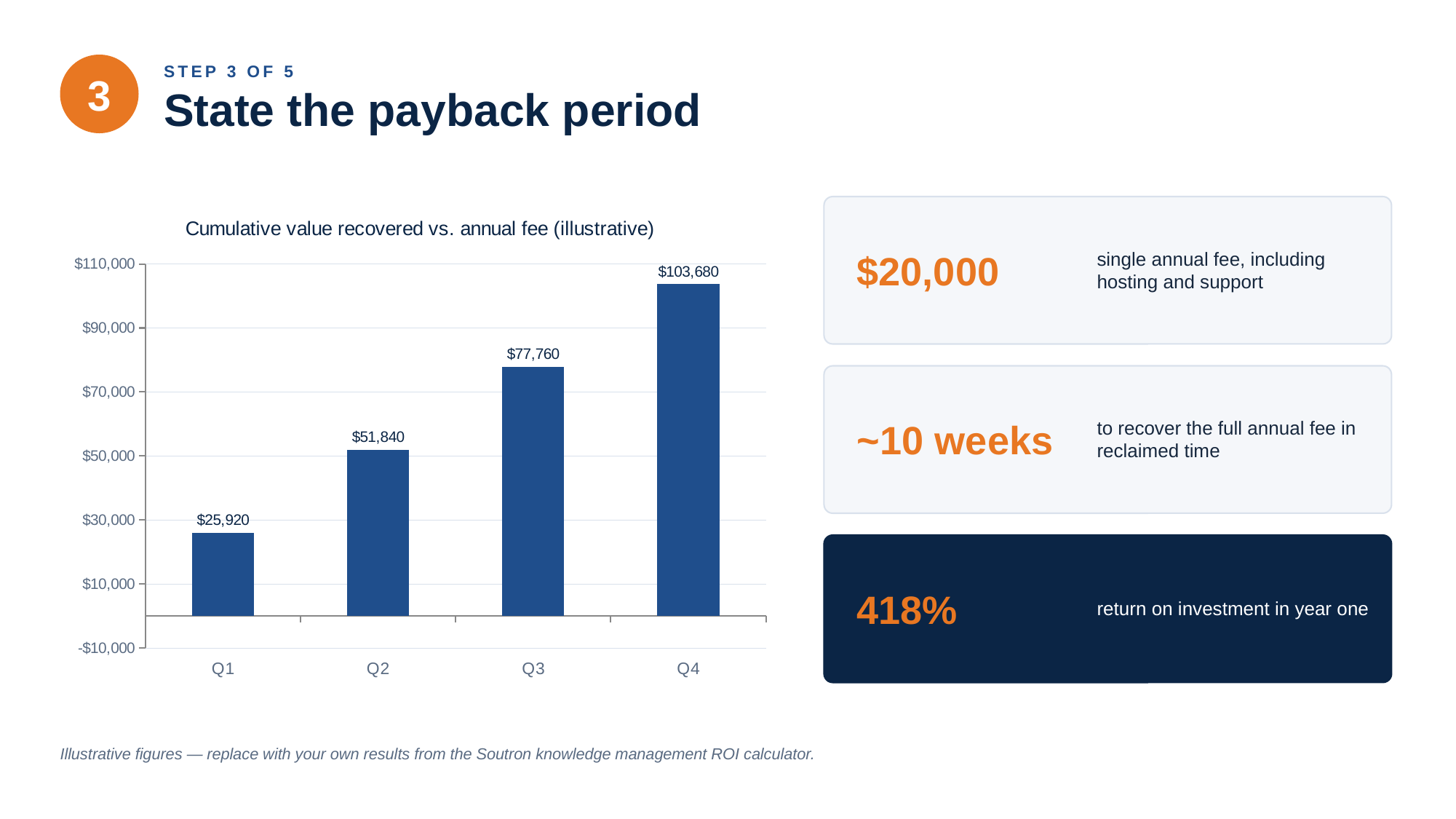
What kind of chart is shown on the slide? Bar chart What is the cumulative value recovered in Q4? $103,680 Do the values rise or fall from Q1 to Q4? Rise Which is larger, the value for Q2 or the value for Q3? Q3 Is the value for Q2 greater or less than $50,000? greater What is the difference between the Q2 and Q1 values? $25,920 Which quarter has the lowest cumulative value recovered? Q1 Which quarter has the highest cumulative value recovered? Q4 How many quarters are shown on the x axis? 4 What is the cumulative value recovered in Q1? $25,920 What is the difference between the Q4 and Q3 values? $25,920 What is the cumulative value recovered in Q3? $77,760